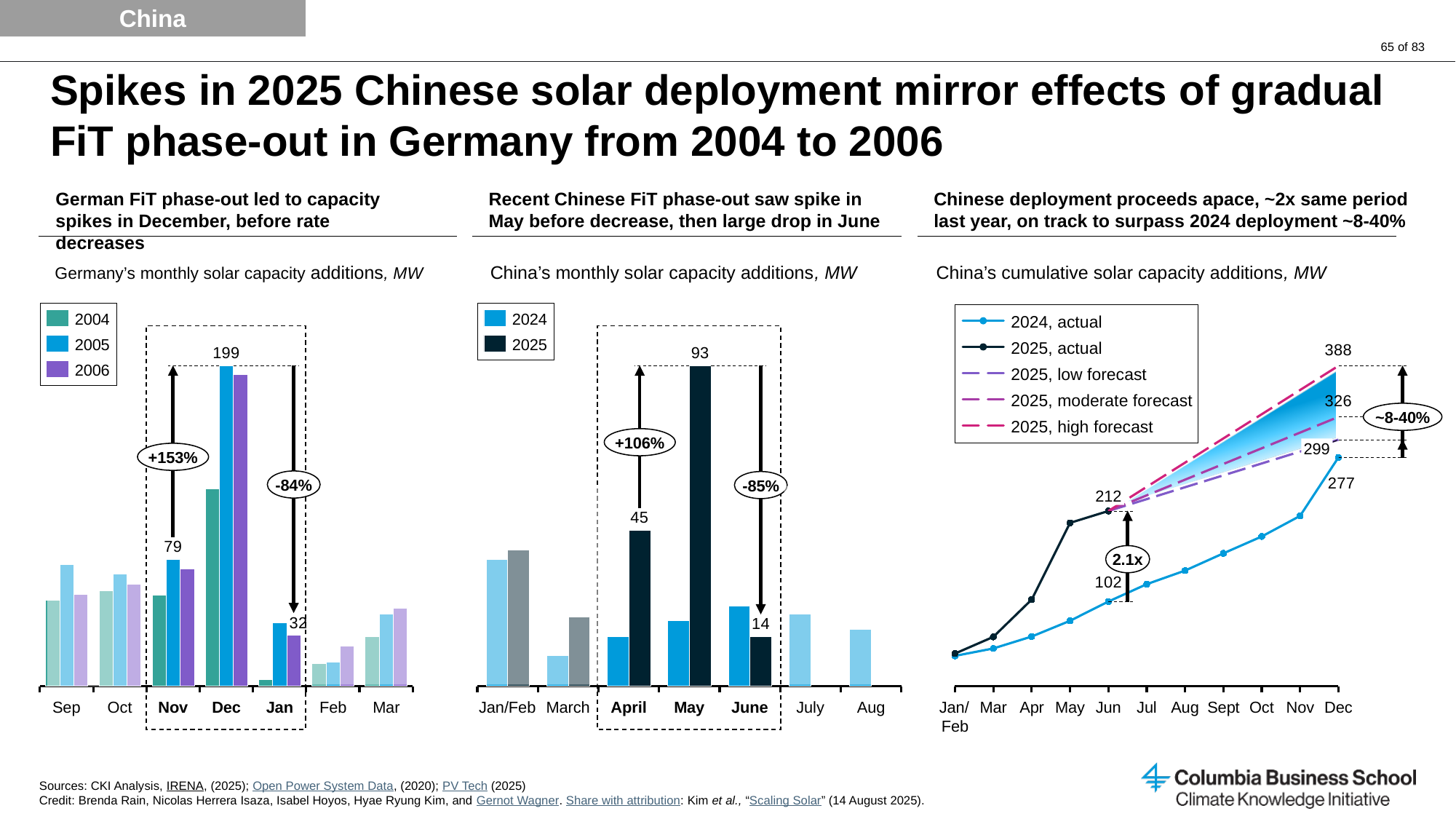
In the chart titled "Germany's monthly solar capacity additions, MW", what is the value for 2005 in Dec? 199 In the chart titled "Germany's monthly solar capacity additions, MW", what is the value for 2005 in Nov? 79 In the chart titled "Germany's monthly solar capacity additions, MW", how many series does the legend list? 3 In the chart titled "China's monthly solar capacity additions, MW", what is the difference between the 2025 values for May and June? 79 In the chart titled "China's cumulative solar capacity additions, MW", what is the value for 2025, actual in Jun? 212 In the chart titled "China's monthly solar capacity additions, MW", what is the value for 2025 in June? 14 In the chart titled "China's monthly solar capacity additions, MW", how many month categories are shown on the x axis? 7 In the chart titled "China's monthly solar capacity additions, MW", what is the value for 2025 in May? 93 In the chart titled "China's cumulative solar capacity additions, MW", what is the value for the 2025, high forecast in Dec? 388 In the chart titled "China's cumulative solar capacity additions, MW", how many series does the legend list? 5 In the chart titled "Germany's monthly solar capacity additions, MW", what kind of chart is it? bar chart In the chart titled "Germany's monthly solar capacity additions, MW", what is the difference between the 2005 values for Dec and Nov? 120